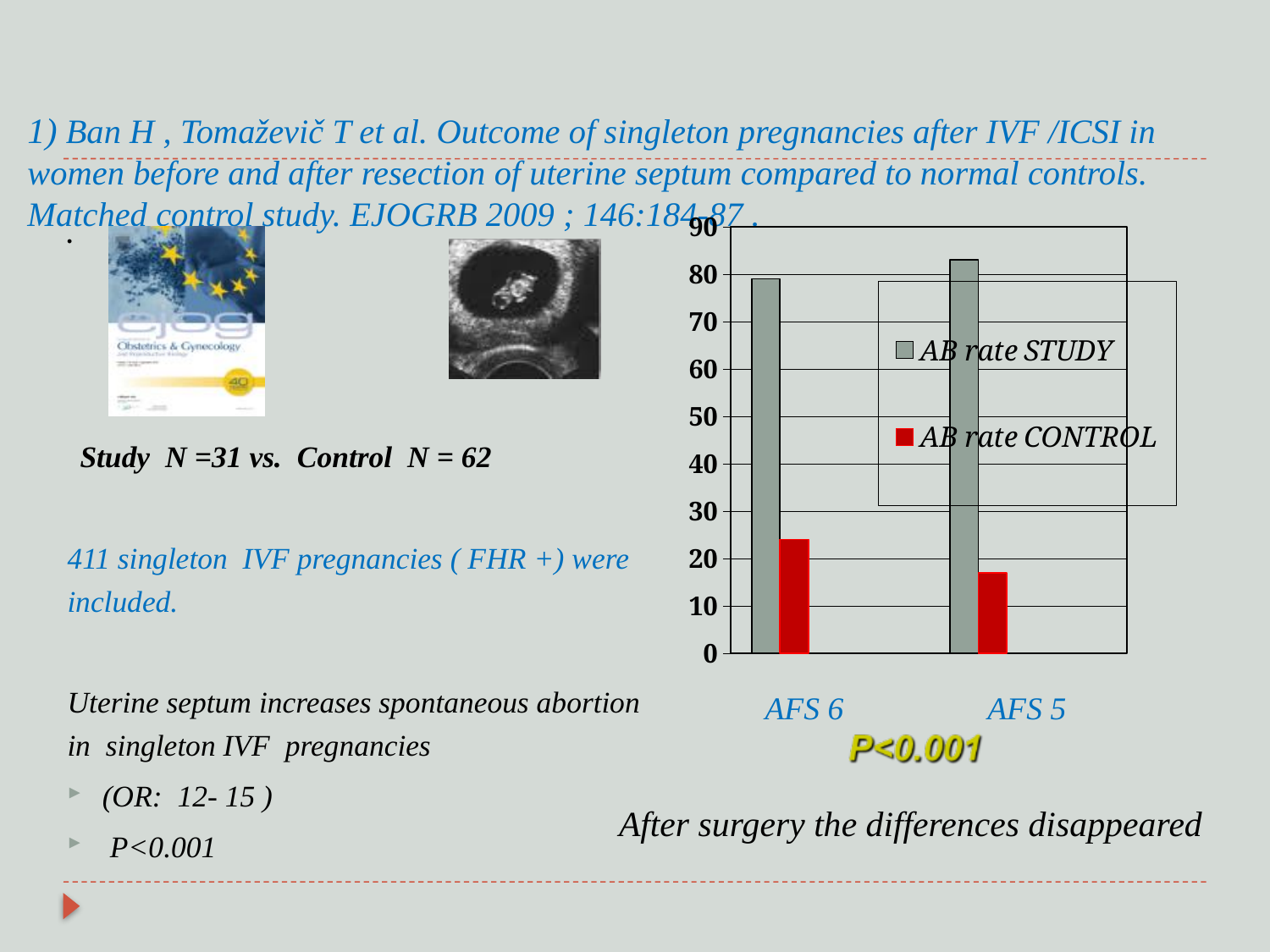
Is the AB rate STUDY value for AFS 6 greater or less than 70? greater For AFS 6, which is larger: the AB rate STUDY value or the AB rate CONTROL value? AB rate STUDY Which colour represents the AB rate CONTROL series in the chart? red What kind of chart is shown on the slide? bar chart Is the AB rate CONTROL value for AFS 5 greater or less than 20? less Is the AB rate STUDY value for AFS 5 greater or less than 70? greater How many categories are shown on the x axis of the chart? 2 Which category has the higher AB rate CONTROL value, AFS 6 or AFS 5? AFS 6 Which bar in the chart is the lowest? AB rate CONTROL for AFS 5 What are the two series named in the chart legend? AB rate STUDY and AB rate CONTROL How many series does the chart legend list? 2